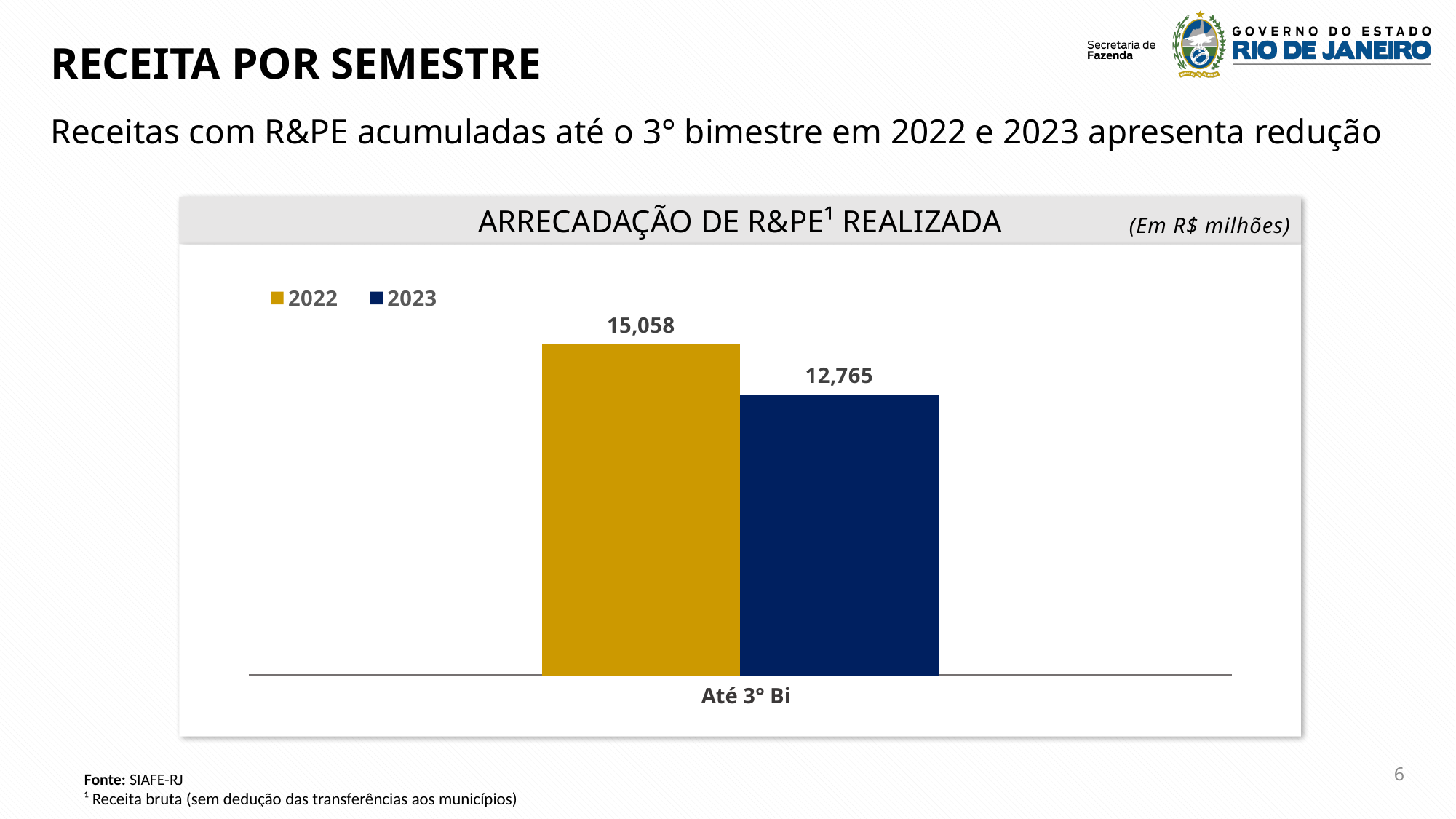
In what unit are the chart values expressed? R$ milhões Which series has the lowest value in the chart? 2023 What is the value for 2022 in the 'Até 3° Bi' category? 15,058 How many series does the legend list? 2 What kind of chart is shown on the slide? Bar chart Which series has the higher value for 'Até 3° Bi', 2022 or 2023? 2022 How many categories are shown on the x axis? 1 What is the label of the category on the x axis? Até 3° Bi What is the title of the chart? ARRECADAÇÃO DE R&PE¹ REALIZADA What is the value for 2023 in the 'Até 3° Bi' category? 12,765 What is the difference between the 2022 and 2023 values for 'Até 3° Bi'? 2,293